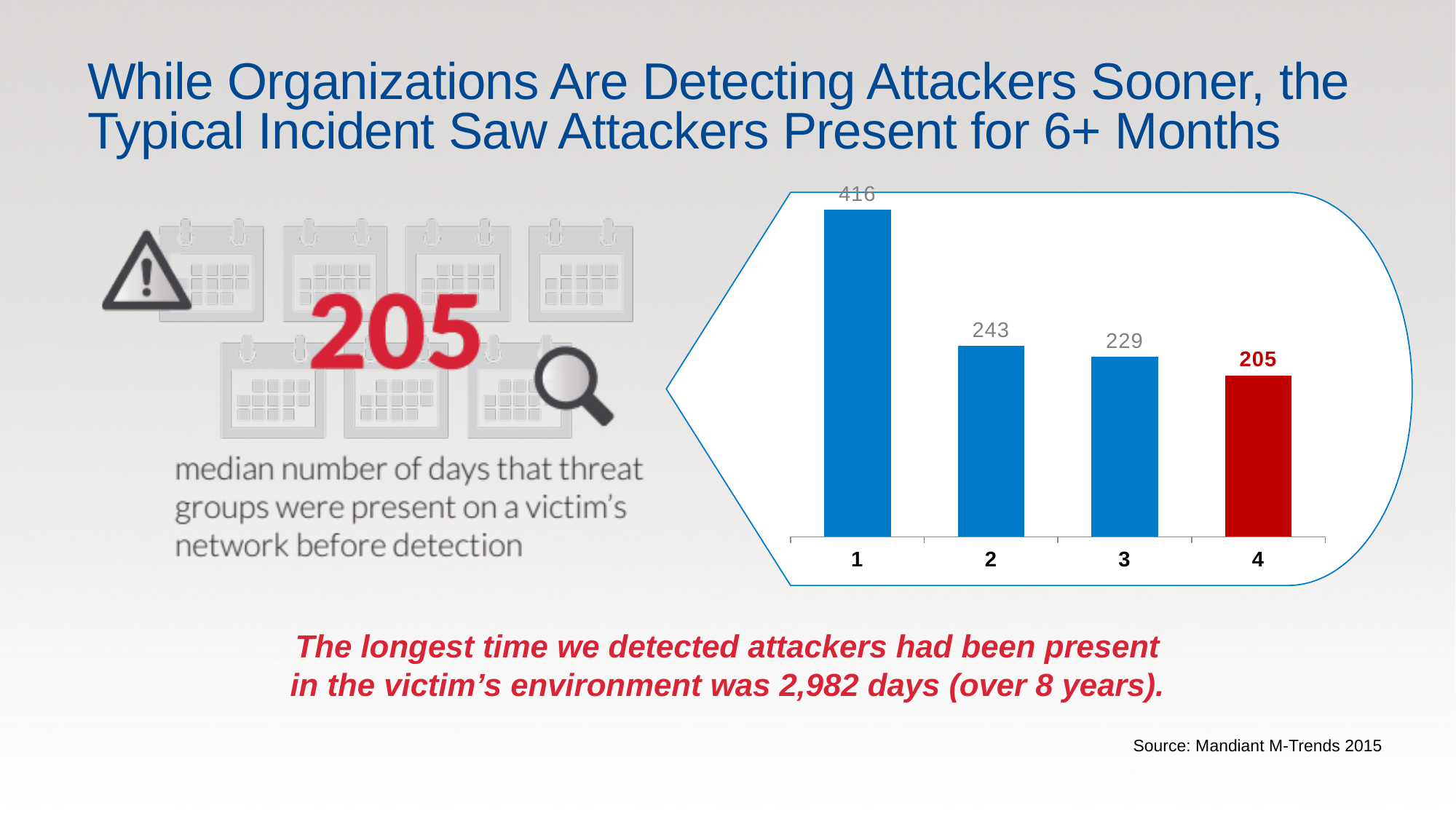
What is the value of the bar for category 2? 243 Which category has the lowest bar? 4 What is the difference between the values for category 1 and category 4? 211 Do the values rise or fall from category 1 to category 4? fall What is the difference between the values for category 2 and category 3? 14 What is the value of the bar for category 4? 205 What is the value of the bar for category 1? 416 Which is larger, the value for category 2 or the value for category 4? category 2 How many bars are shown in the chart? 4 What is the value of the bar for category 3? 229 Which category has the highest bar? 1 What kind of chart is shown on the slide? bar chart